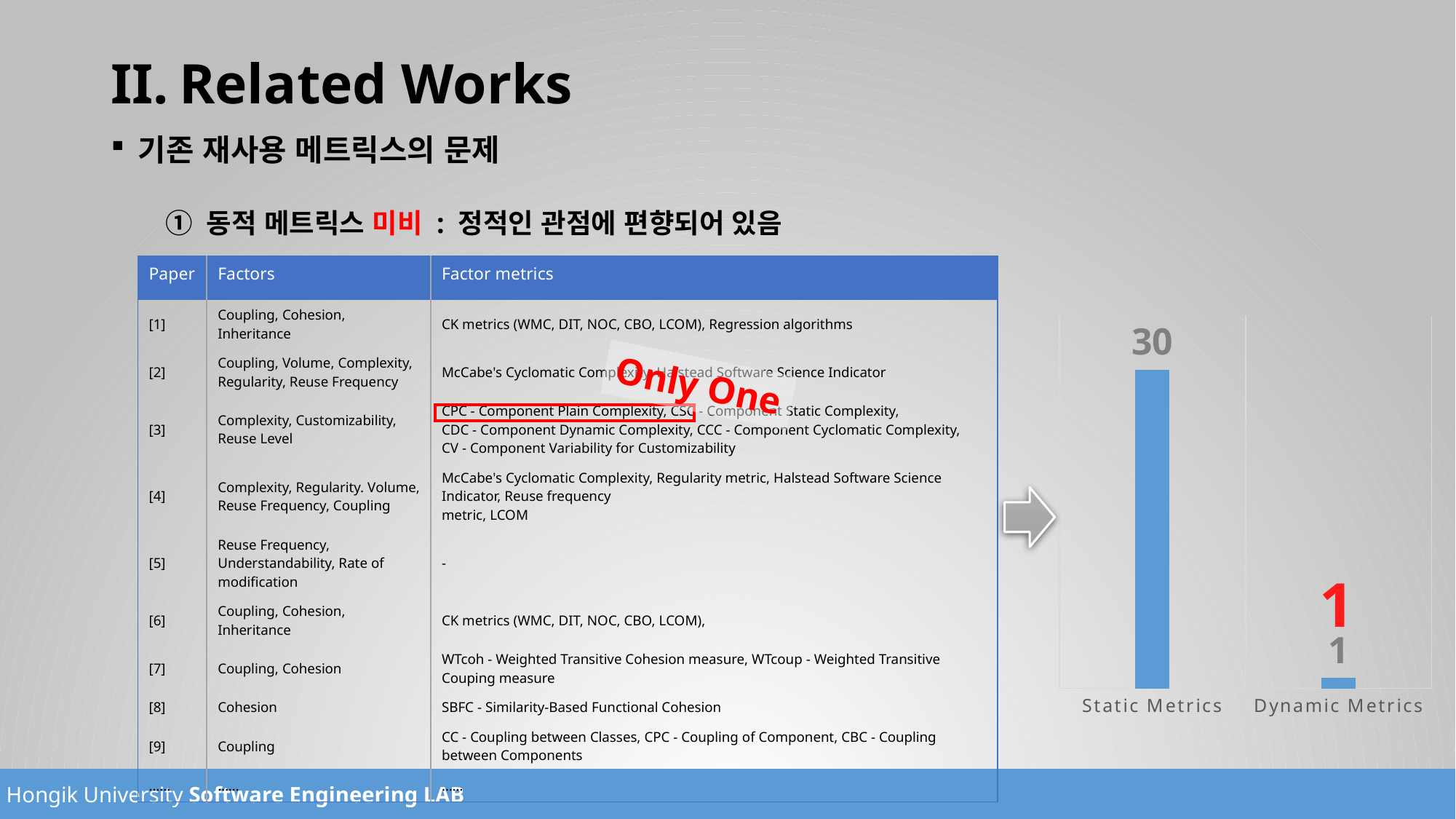
What kind of chart is shown on the slide? bar chart What colour are the bars in the chart? blue How many categories are shown in the chart? 2 Which category has the highest value? Static Metrics Which is larger, the value for Static Metrics or the value for Dynamic Metrics? Static Metrics Which category has the lowest value? Dynamic Metrics Do the values rise or fall from Static Metrics to Dynamic Metrics? fall What is the value for Dynamic Metrics? 1 What is the total of the two bar values in the chart? 31 What is the value for Static Metrics? 30 What is the difference between the values for Static Metrics and Dynamic Metrics? 29